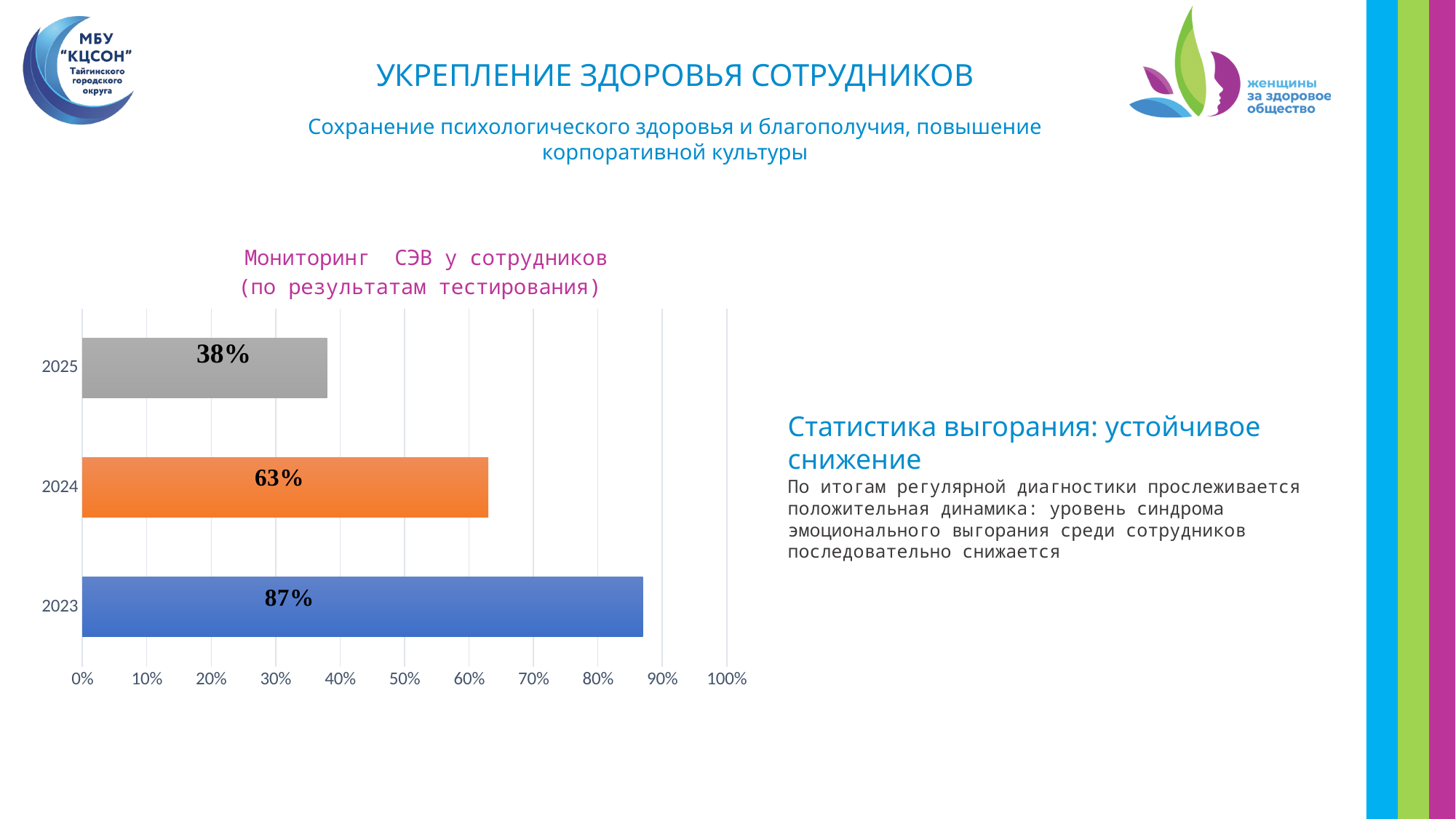
Which year has the lowest value? 2025 What is the difference between the values for 2023 and 2025? 49% What kind of chart is shown on the slide? bar chart Which is larger, the value for 2024 or the value for 2025? 2024 What is the value for 2024? 63% What is the difference between the values for 2024 and 2025? 25% How many years are shown in the chart? 3 What is the value for 2023? 87% What is the title of the chart? Мониторинг СЭВ у сотрудников (по результатам тестирования) Which year has the highest value? 2023 Is the value for 2023 greater or less than 80%? greater What is the value for 2025? 38%